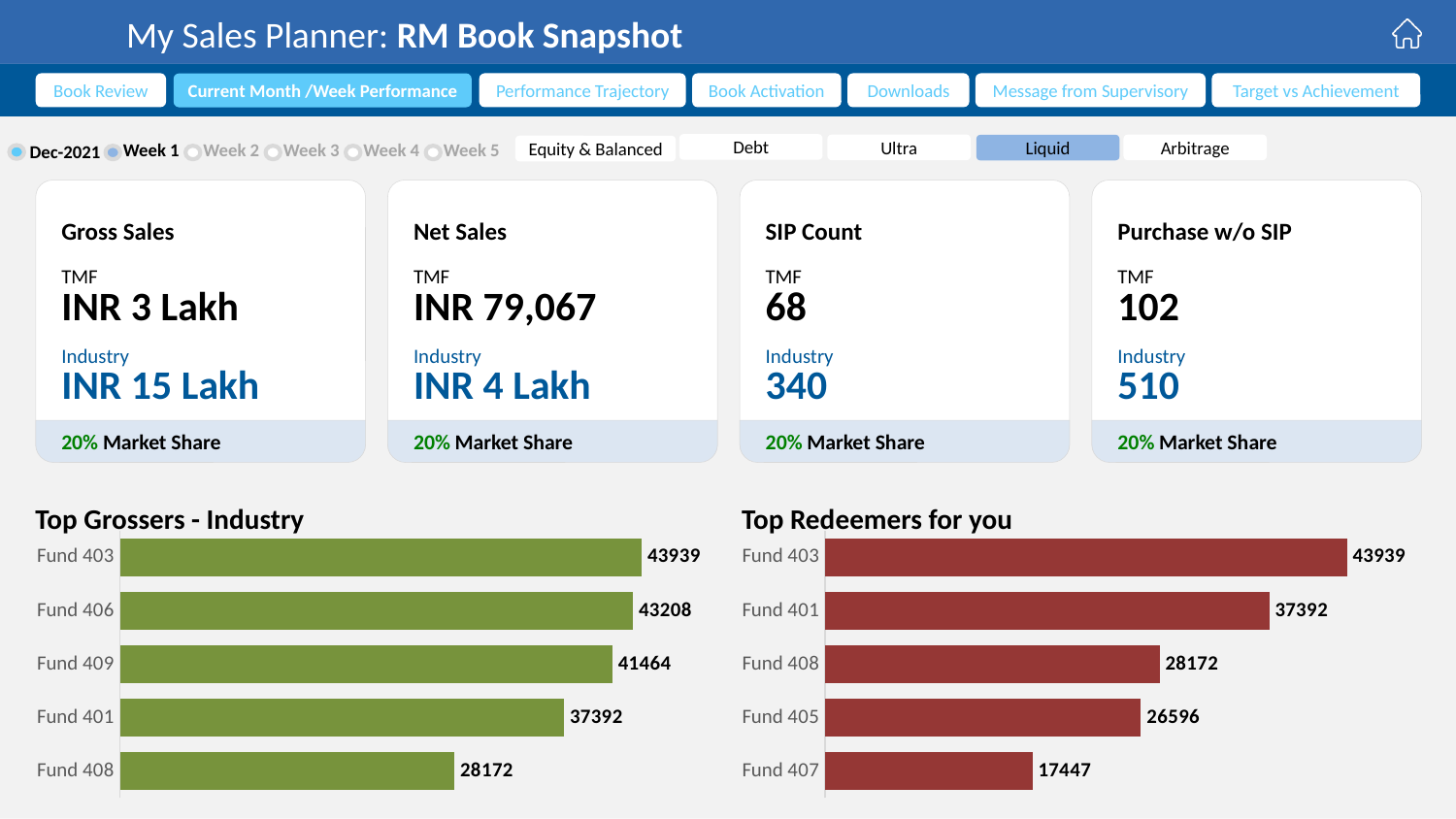
What colour are the bars in the 'Top Grossers - Industry' chart? Green In the 'Top Grossers - Industry' chart, which fund has the lowest value? Fund 408 In the 'Top Grossers - Industry' chart, how many funds are shown? 5 In the 'Top Redeemers for you' chart, do the values rise or fall from the top bar to the bottom bar? Fall In the 'Top Redeemers for you' chart, which fund has the lowest value? Fund 407 In the 'Top Grossers - Industry' chart, what is the difference between the values for Fund 409 and Fund 401? 4072 In the 'Top Redeemers for you' chart, what is the value for Fund 405? 26596 In the 'Top Redeemers for you' chart, what is the difference between the values for Fund 403 and Fund 401? 6547 In the 'Top Grossers - Industry' chart, what is the value for Fund 406? 43208 What kind of chart is the 'Top Redeemers for you' chart? Bar chart In the 'Top Grossers - Industry' chart, which fund has the highest value? Fund 403 In the 'Top Redeemers for you' chart, which is larger, the value for Fund 408 or the value for Fund 405? Fund 408